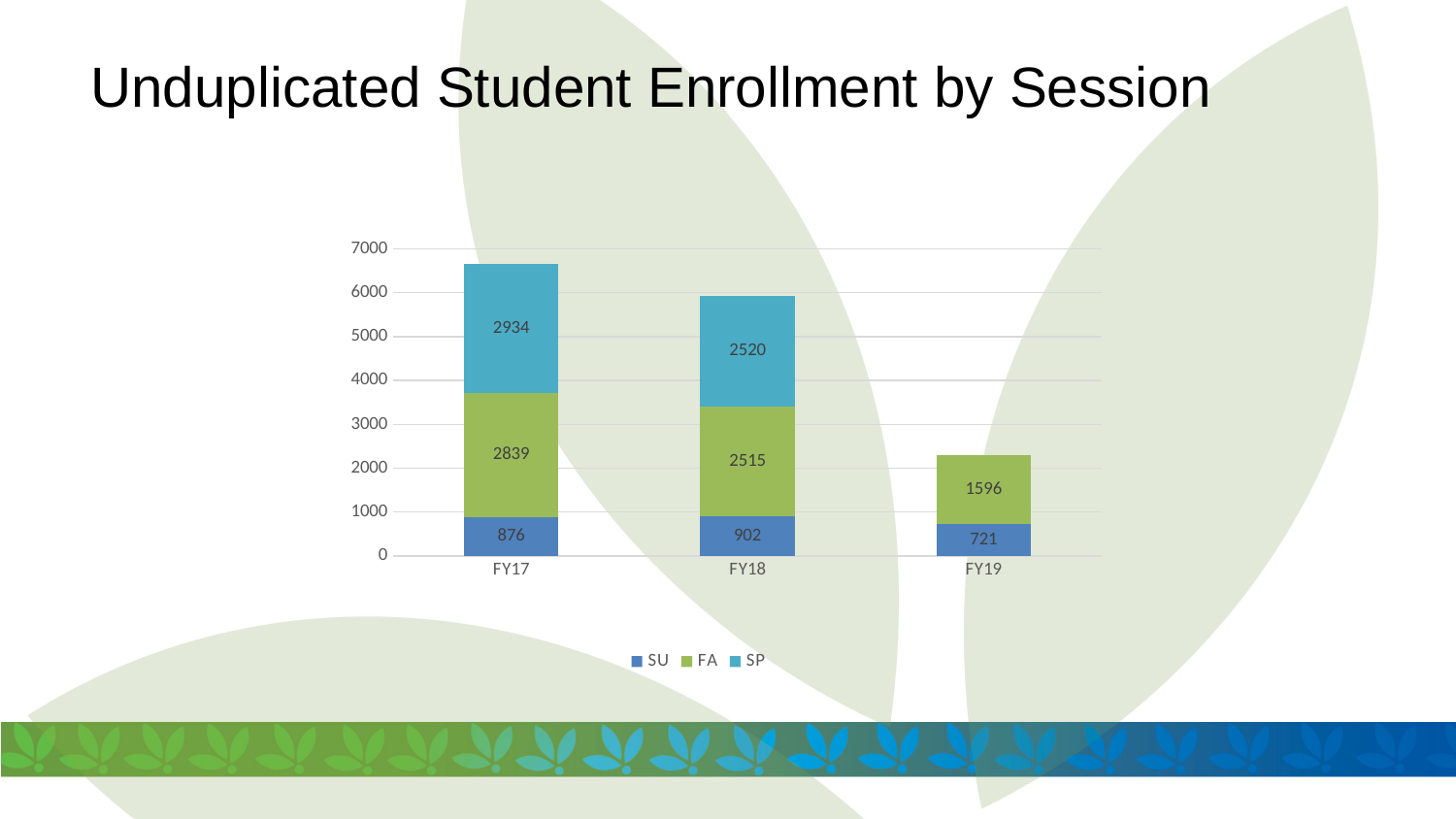
What is the total of the stacked bar for FY19? 2317 What kind of chart is shown on the slide? Stacked bar chart What is the total of the stacked bar for FY18? 5937 Which is larger, the SP value for FY17 or the SP value for FY18? FY17 Which fiscal year has the highest SU value? FY18 Which fiscal year has the lowest FA value? FY19 What is the SP value for FY18? 2520 How many fiscal years are shown on the x axis? 3 What is the SU value for FY17? 876 What is the FA value for FY19? 1596 What is the difference between the FA values for FY17 and FY18? 324 How many series does the legend list? 3